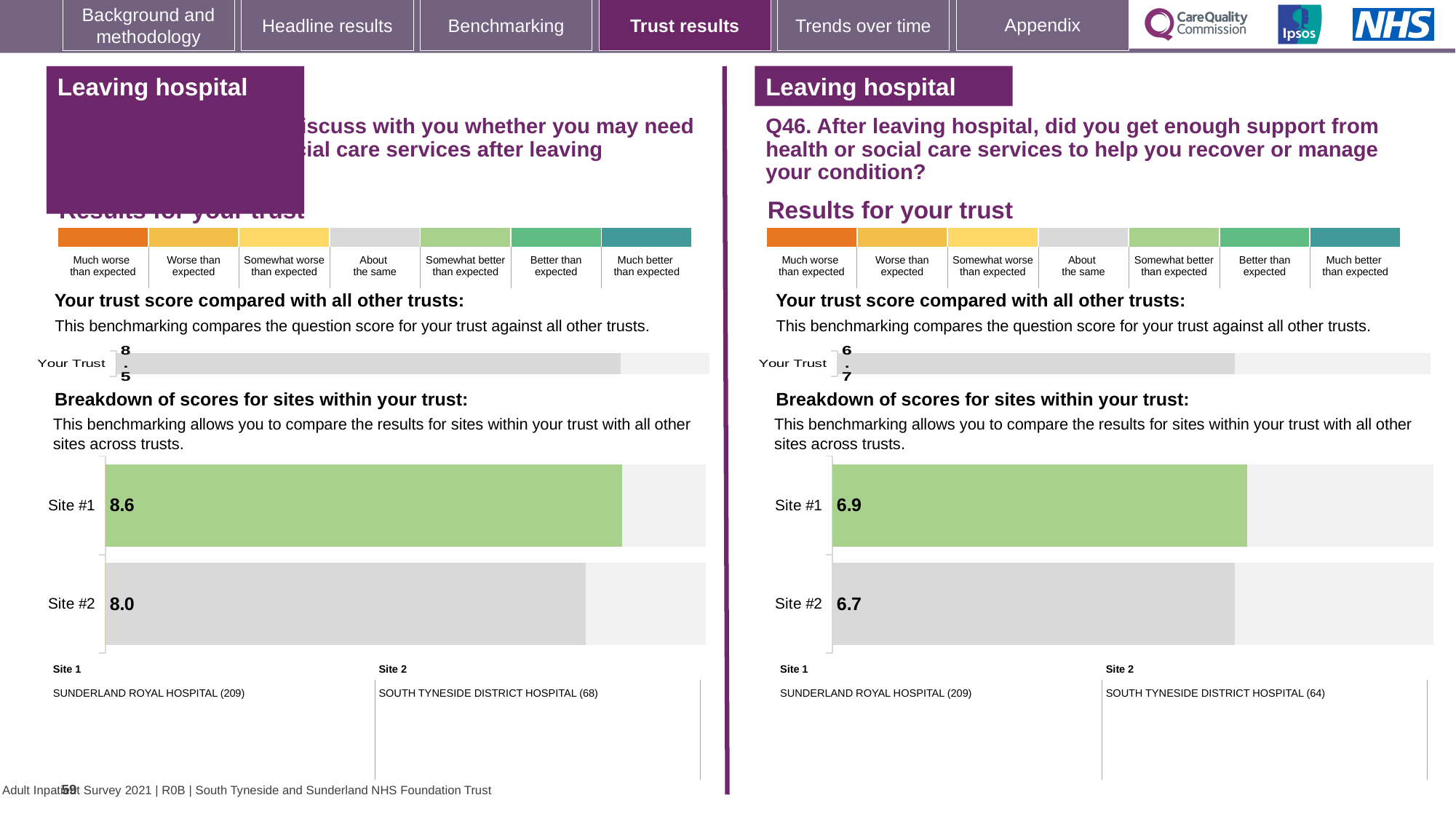
In the site breakdown chart on the right-hand side (Q46), what is the score for Site #1? 6.9 In the site breakdown chart on the right-hand side (Q46), what is the difference between the Site #1 and Site #2 scores? 0.2 In the site breakdown chart on the left-hand side, what is the difference between the Site #1 and Site #2 scores? 0.6 In the site breakdown chart on the left-hand side, what is the score for Site #2? 8.0 What type of chart is used for the site breakdown on the left-hand side? Bar chart In the site breakdown chart on the left-hand side, what is the score for Site #1? 8.6 How many sites are shown in the site breakdown chart on the right-hand side (Q46)? 2 On the right-hand side (Q46), what is the score shown for Your Trust? 6.7 In the site breakdown chart on the right-hand side (Q46), what is the score for Site #2? 6.7 On the left-hand side, what is the score shown for Your Trust? 8.5 In the site breakdown chart on the right-hand side (Q46), which site has the lower score? Site #2 In the site breakdown chart on the left-hand side, which site has the higher score? Site #1